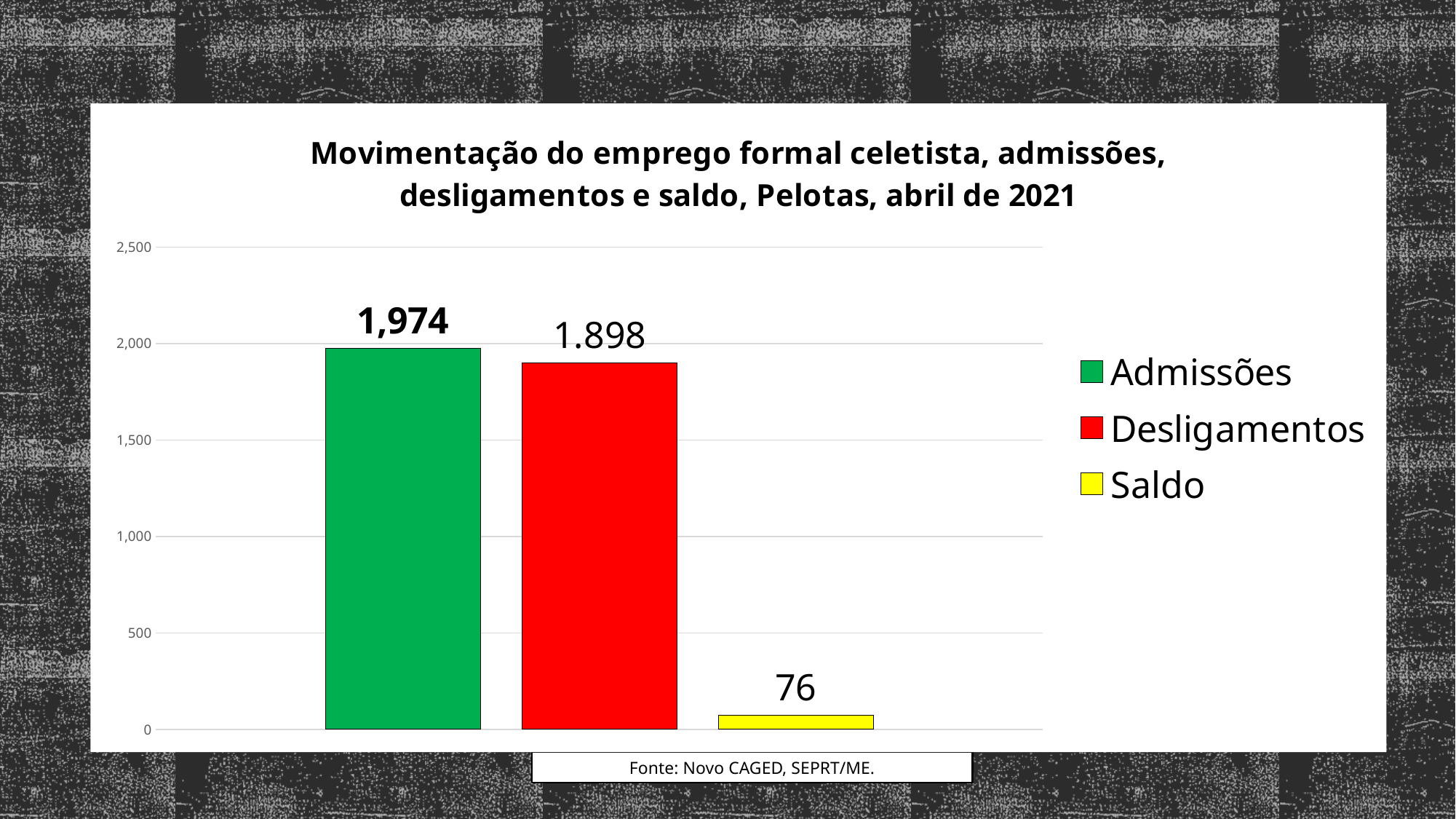
Is the value for Saldo greater or less than 500? less Is the value for Desligamentos greater or less than 2,000? less Which series has the highest value? Admissões Which is larger, Admissões or Desligamentos? Admissões Which series has the lowest value? Saldo What is the value shown for Admissões? 1,974 What kind of chart is shown on the slide? bar chart What colour is the bar for Saldo? yellow What is the difference between the Admissões value and the Desligamentos value? 76 How many series does the legend list? 3 What is the value shown for Desligamentos? 1.898 What is the value shown for Saldo? 76